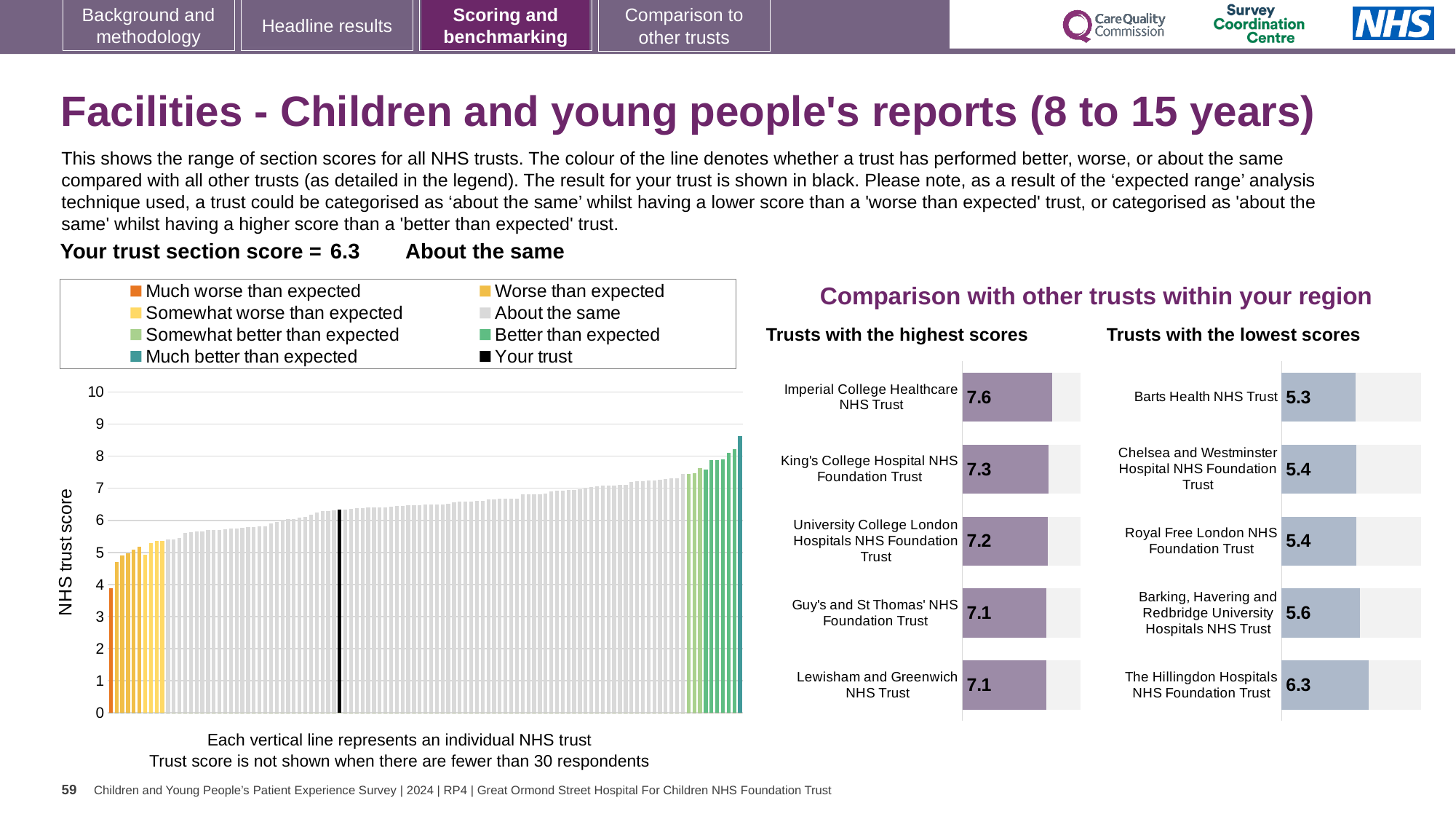
In the 'Trusts with the highest scores' chart, what is the score for Imperial College Healthcare NHS Trust? 7.6 In the large chart on the left, is the value of the tallest bar greater or less than 8? greater What kind of chart is the large chart on the left showing NHS trust scores? Bar chart How many entries does the legend above the large chart on the left list? 8 In the 'Trusts with the lowest scores' chart, which trust has the lowest score? Barts Health NHS Trust In the 'Trusts with the highest scores' chart, which trust has the highest score? Imperial College Healthcare NHS Trust In the 'Trusts with the highest scores' chart, which has the higher score: King's College Hospital NHS Foundation Trust or University College London Hospitals NHS Foundation Trust? King's College Hospital NHS Foundation Trust In the 'Trusts with the lowest scores' chart, what is the score for The Hillingdon Hospitals NHS Foundation Trust? 6.3 In the 'Trusts with the lowest scores' chart, what is the score for Barts Health NHS Trust? 5.3 How many trusts are listed in the 'Trusts with the highest scores' chart? 5 In the large chart on the left, do the NHS trust scores rise or fall from left to right? Rise In the 'Trusts with the highest scores' chart, what is the difference between the scores of Imperial College Healthcare NHS Trust and Lewisham and Greenwich NHS Trust? 0.5